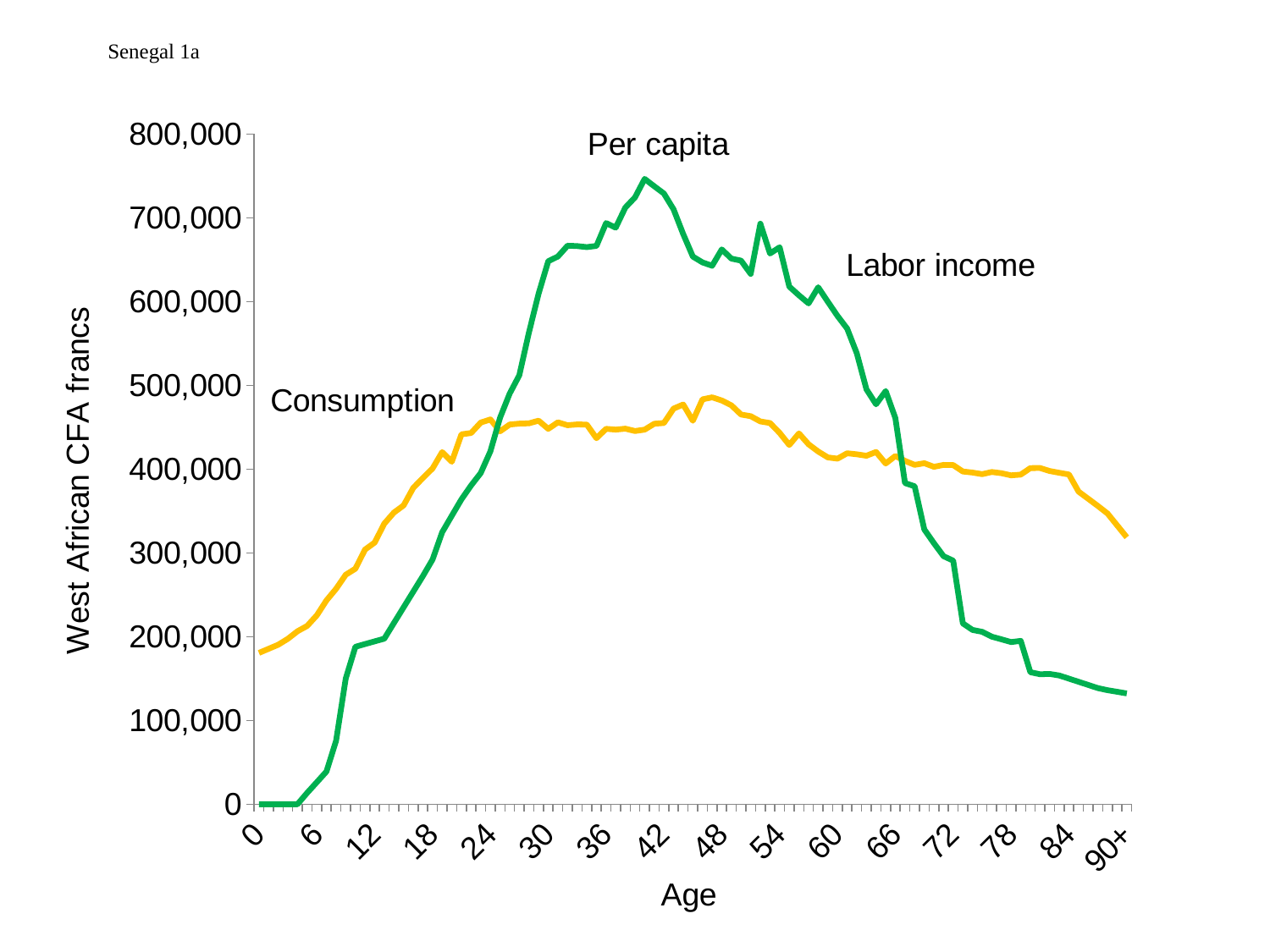
Is the value of Labor income at age 90+ greater or less than 200,000? less What is the label of the vertical axis? West African CFA francs What is the title of the chart? Per capita At age 12, which is higher, Labor income or Consumption? Consumption Does Labor income rise or fall between age 60 and age 90+? fall How many data series are plotted on the chart? 2 What type of chart is shown on the slide? line chart Is the peak value of Labor income (around age 40) greater or less than 700,000? greater At age 42, which is higher, Labor income or Consumption? Labor income Is the value of Consumption at age 0 greater or less than 300,000? less What is the value of Labor income at age 0? 0 Does Consumption rise or fall between age 0 and age 24? rise